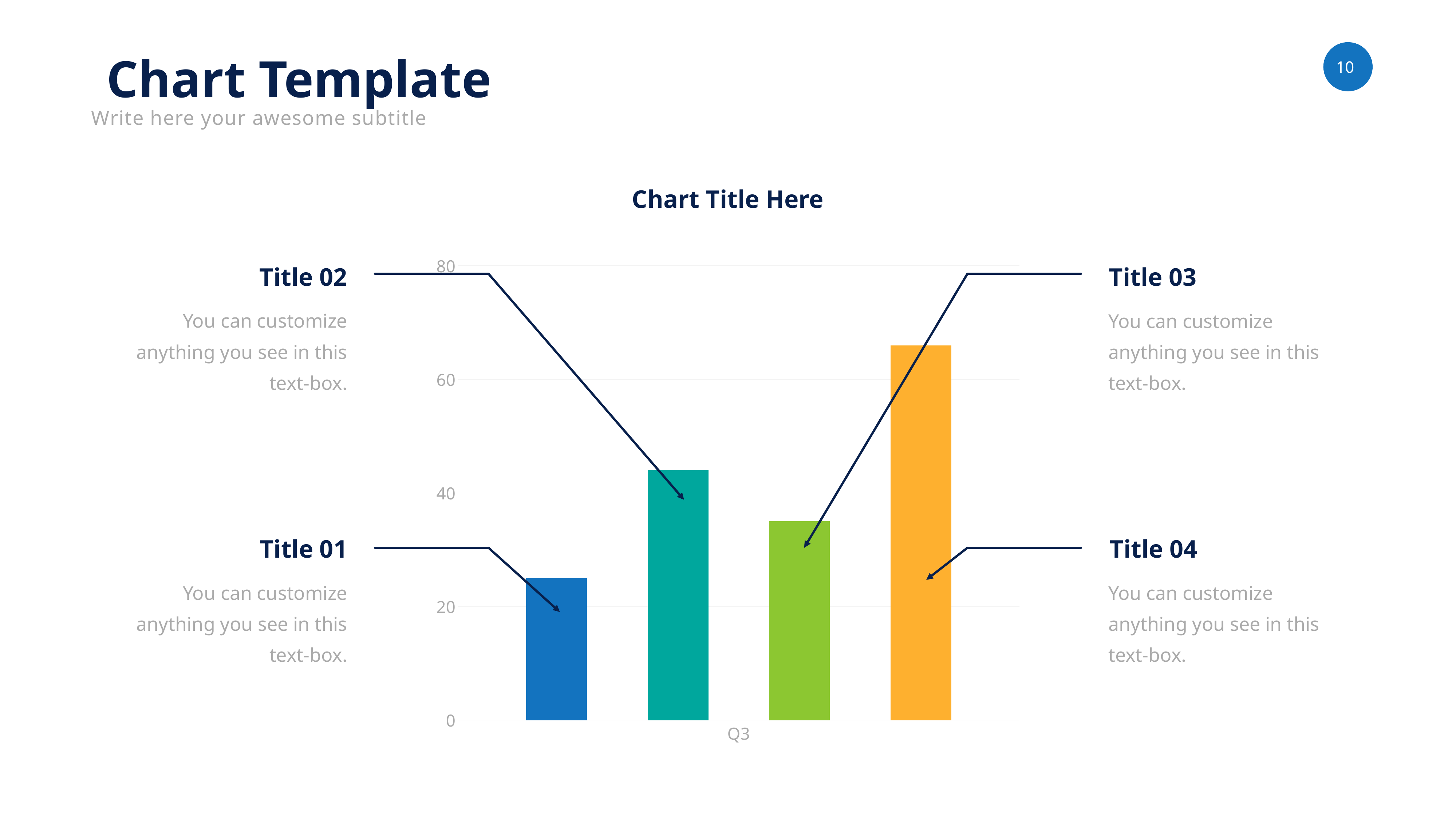
How many bars are plotted in the chart? 4 What is the only category label shown on the x axis? Q3 Which bar is the shortest in the chart? Title 01 Is the value for Title 04 greater or less than 60? greater Is the value for Title 01 greater or less than 40? less What is the title of the chart? Chart Title Here Which is larger, the value for Title 02 or the value for Title 03? Title 02 Is the value for Title 02 greater or less than 40? greater Which is larger, the value for Title 01 or the value for Title 04? Title 04 Which bar is the tallest in the chart? Title 04 What kind of chart is shown on the slide? bar chart